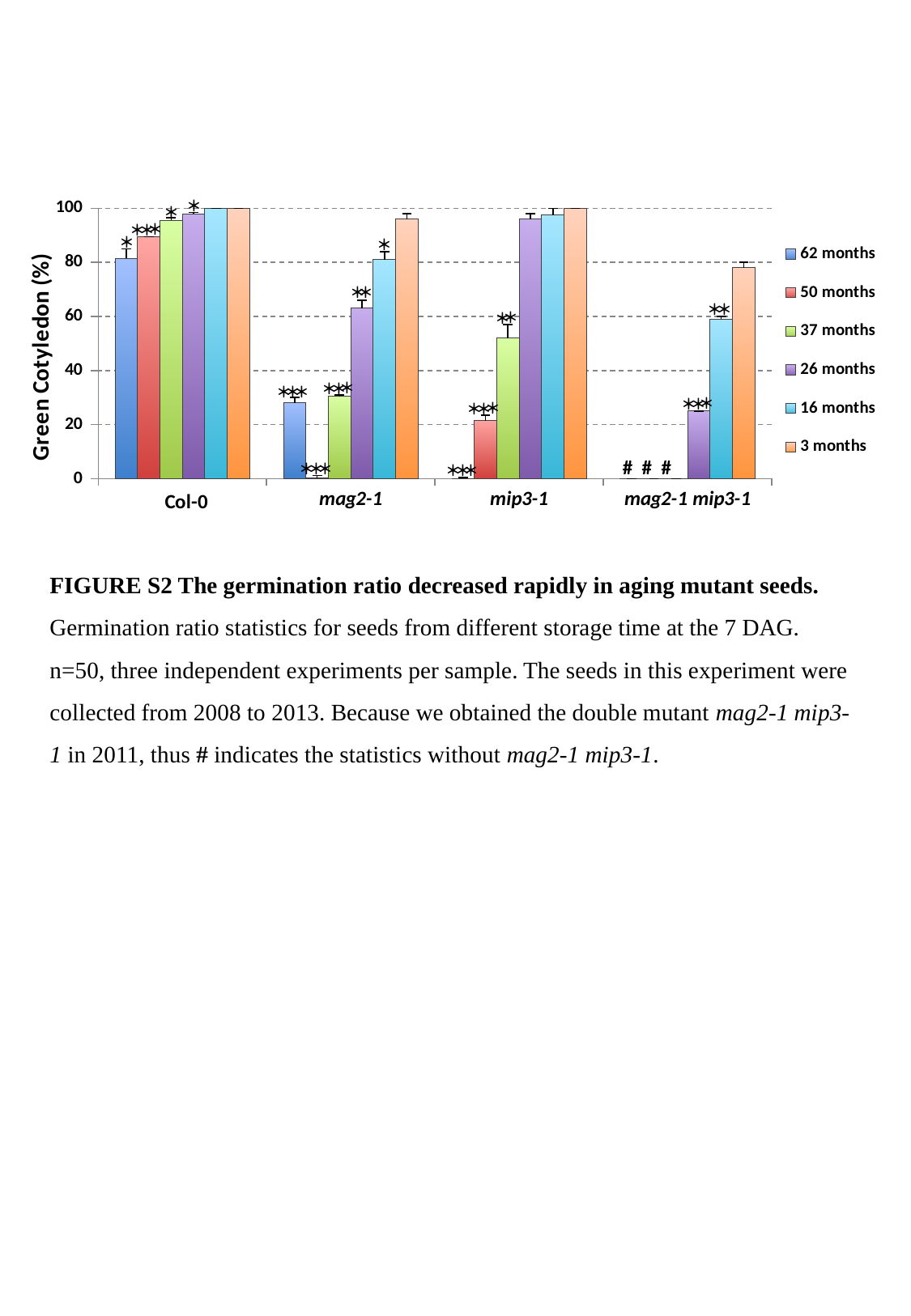
What is the title of the y axis? Green Cotyledon (%) Is the value for 16 months in mag2-1 greater or less than 60? greater Is the value for 62 months in mag2-1 greater or less than 40? less Is the value for 50 months in mip3-1 greater or less than 40? less Which category has the lowest value for the 3 months series? mag2-1 mip3-1 How many genotype categories are shown on the x axis? 4 How many series does the legend list? 6 Which is larger, the 62 months value for Col-0 or the 62 months value for mag2-1? Col-0 What kind of chart is shown on the slide? bar chart Which is larger, the 26 months value for mag2-1 or the 26 months value for mip3-1? mip3-1